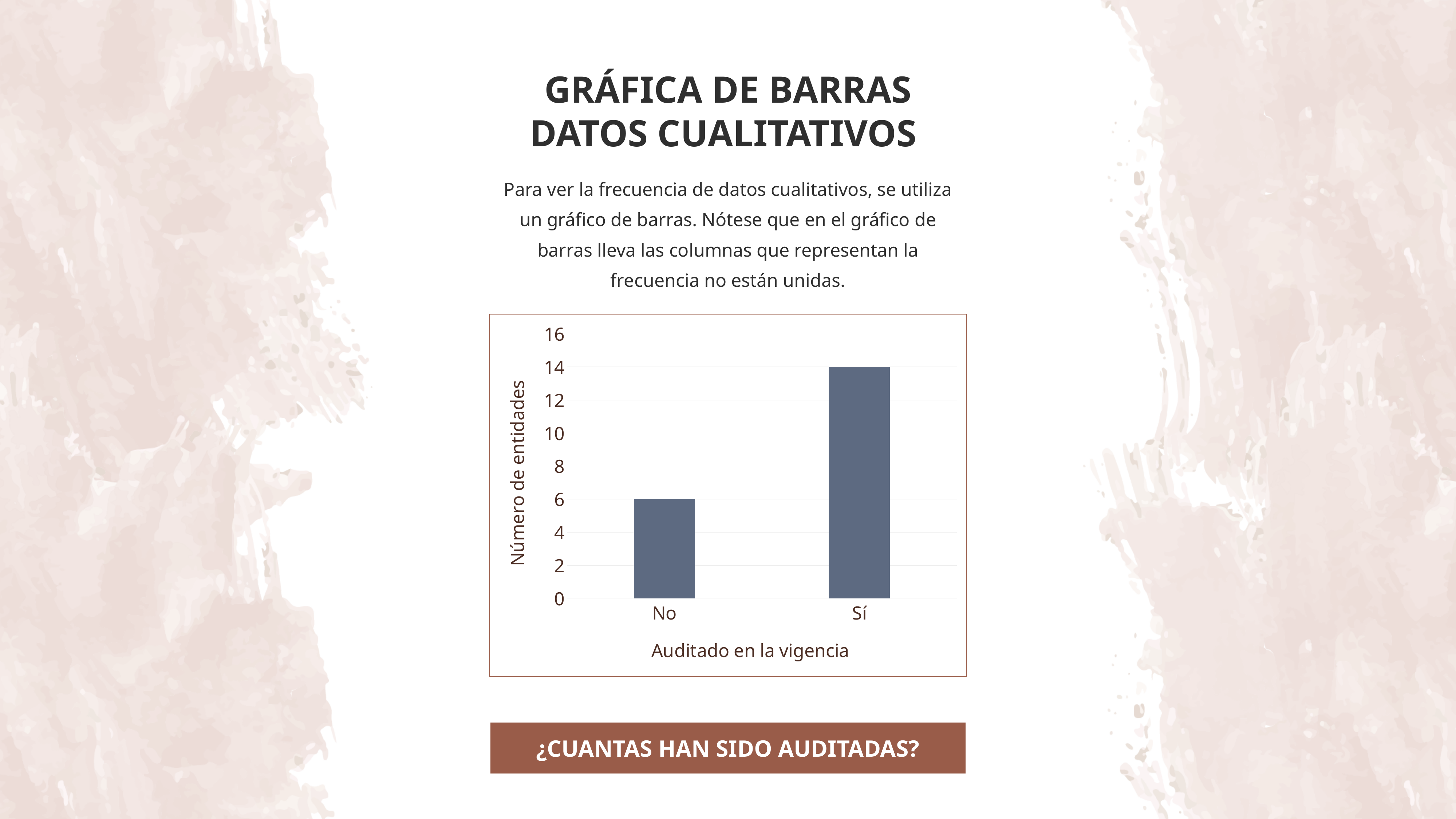
Which is larger, the value for "No" or the value for "Sí"? Sí What is the label of the vertical axis of the chart? Número de entidades What is the value for "No" in the bar chart? 6 What is the label of the horizontal axis of the chart? Auditado en la vigencia What is the difference between the values for "Sí" and "No"? 8 What is the value for "Sí" in the bar chart? 14 Which category has the lowest value in the bar chart? No How many categories are shown on the x axis of the chart? 2 Which category has the highest value in the bar chart? Sí What kind of chart is shown on the slide? bar chart Is the value for "Sí" greater or less than 10? greater Is the value for "No" greater or less than 10? less